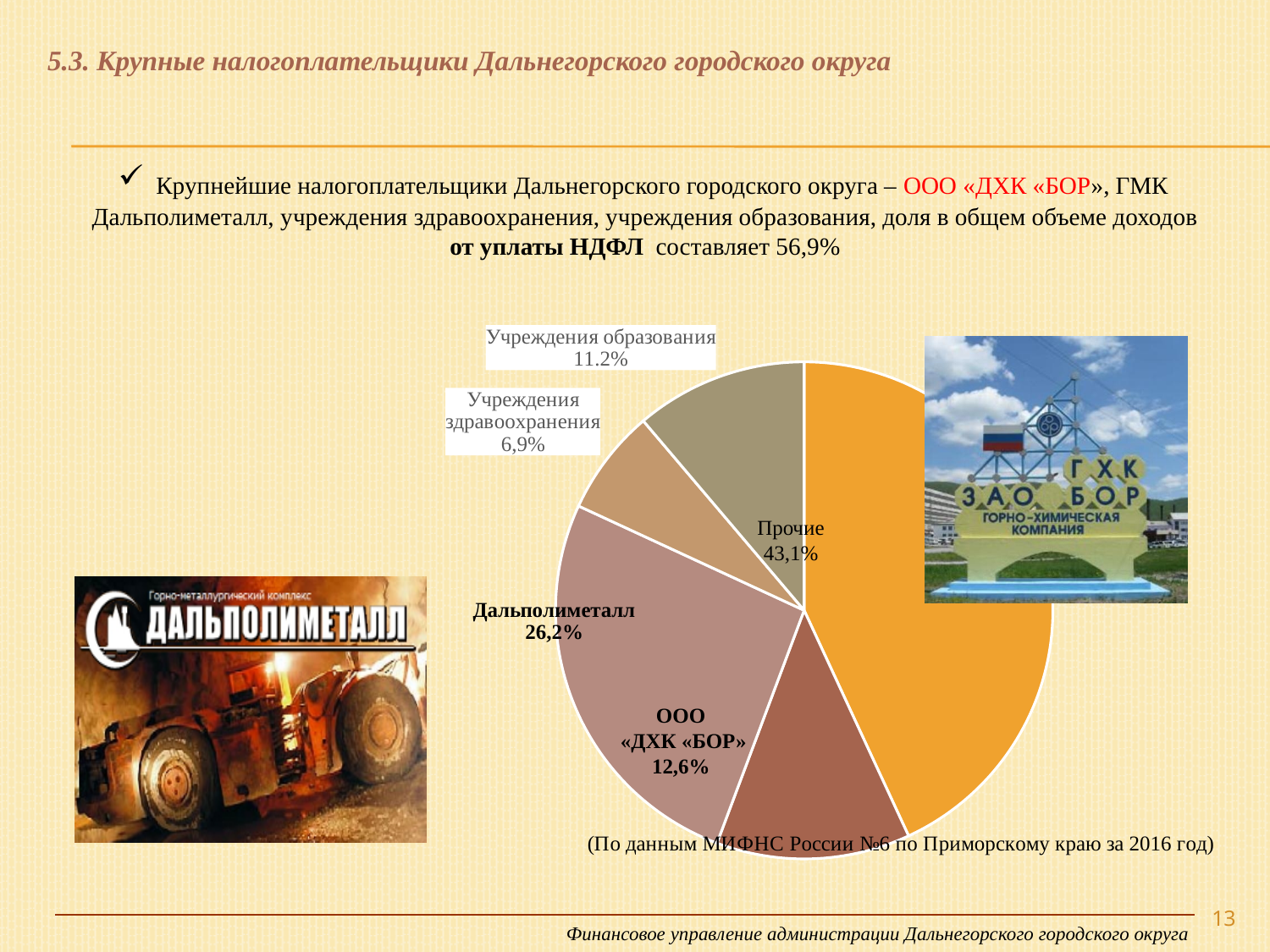
What is the difference between the shares of Прочие and Дальполиметалл? 16,9% What kind of chart is shown on the slide? pie chart Which slice of the pie chart is the largest? Прочие According to the note under the chart, which year's data does the chart use? 2016 What share of the pie does ООО «ДХК «БОР» have? 12,6% How many slices does the pie chart have? 5 Which is larger: the share for Дальполиметалл or the share for ООО «ДХК «БОР»? Дальполиметалл What share of the pie does Прочие have? 43,1% What share of the pie does Дальполиметалл have? 26,2% What share of the pie does Учреждения образования have? 11.2% What share of the pie does Учреждения здравоохранения have? 6,9% Which slice of the pie chart is the smallest? Учреждения здравоохранения